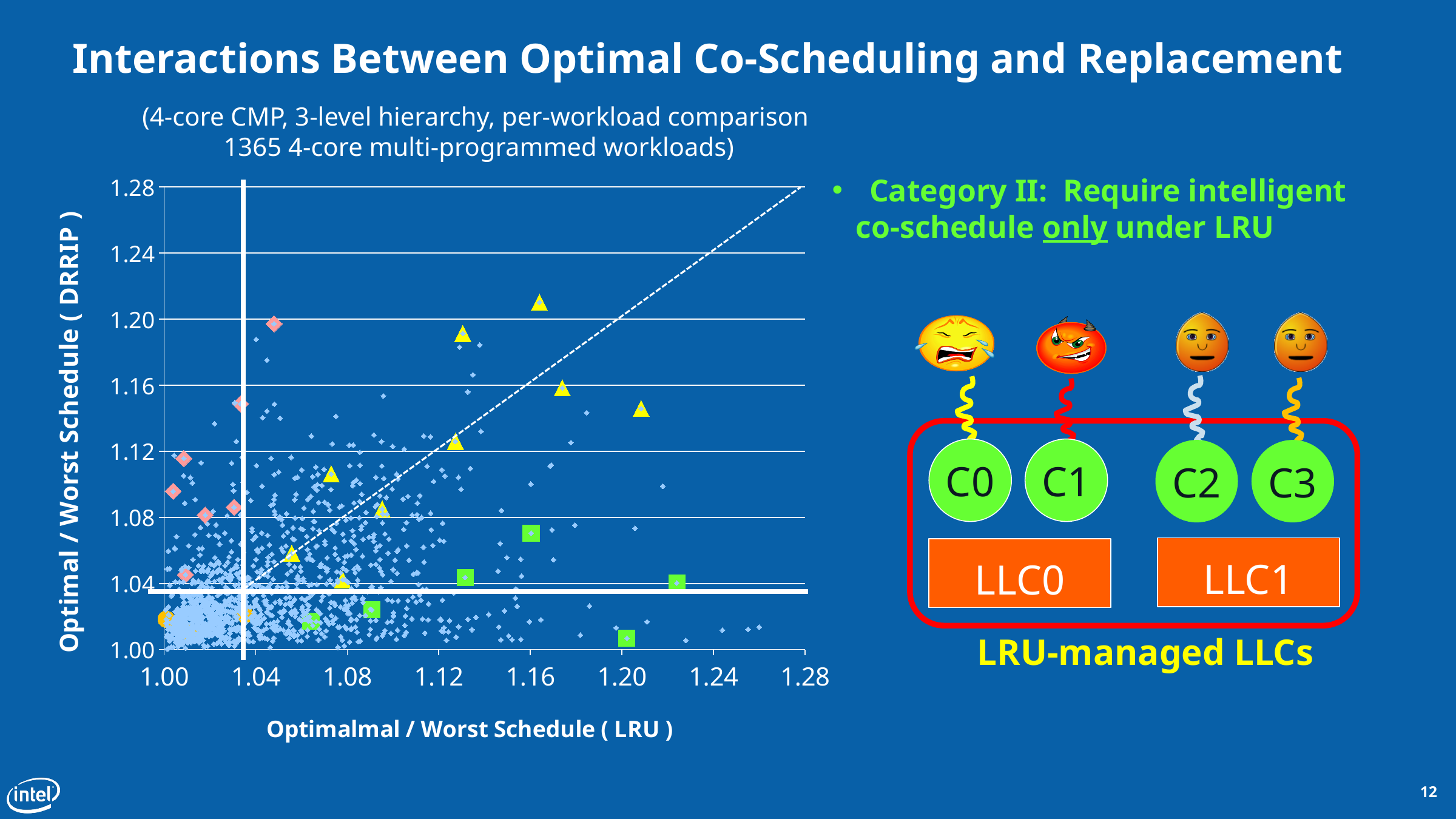
What is the label of the y axis of the chart? Optimal / Worst Schedule ( DRRIP ) What kind of chart is shown on the slide? scatter chart Is the y value of the highest plotted point on the chart greater or less than 1.24? less Is the y value of the highest plotted point on the chart greater or less than 1.20? greater What is the label of the x axis of the chart? Optimalmal / Worst Schedule ( LRU )